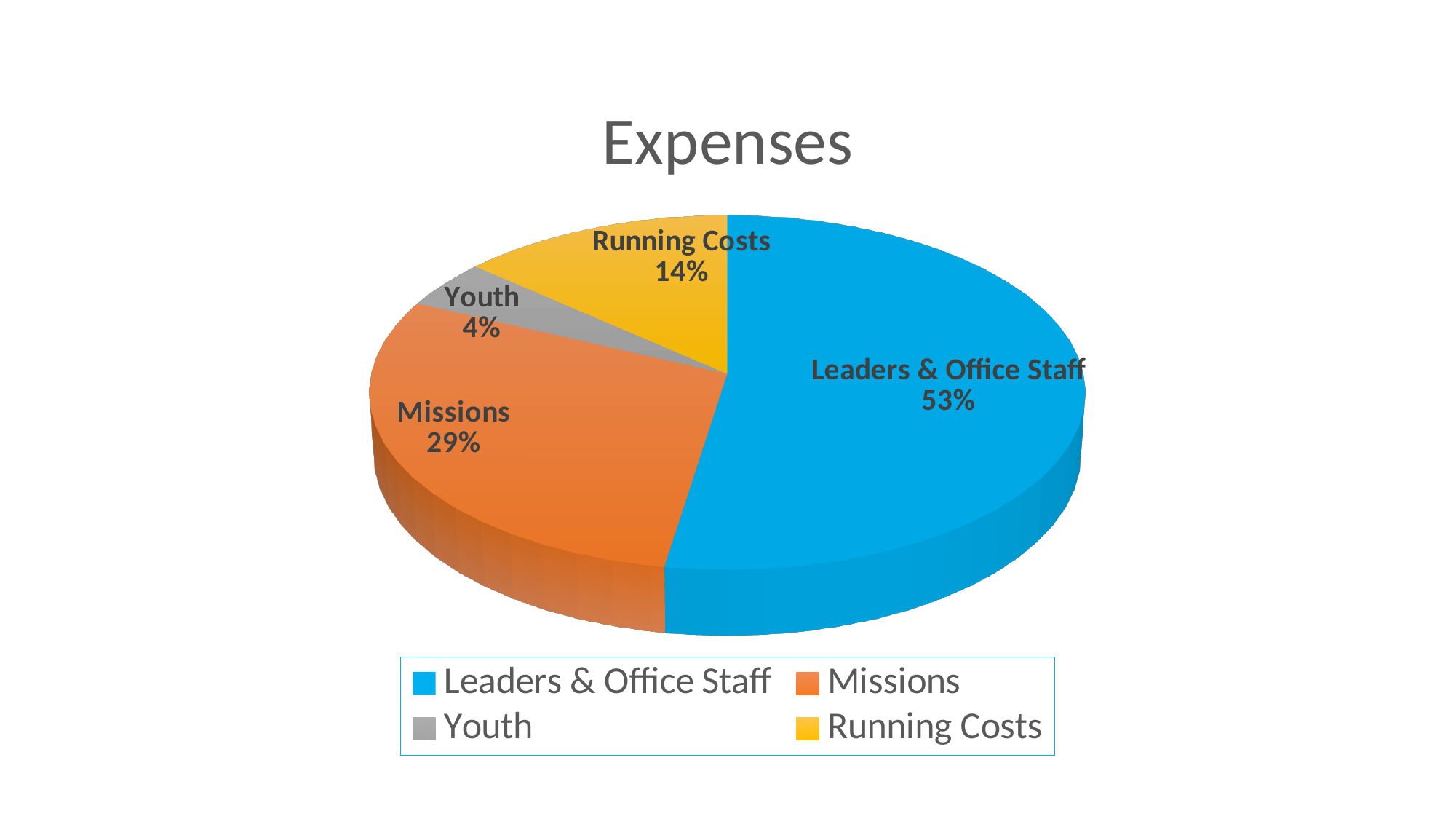
What share of expenses goes to Leaders & Office Staff? 53% What colour represents Missions in the chart? Orange Which category has the largest share of expenses? Leaders & Office Staff How many categories are shown in the pie chart? 4 What kind of chart is shown on the slide? Pie chart Which category has the smallest share of expenses? Youth What is the difference in percentage points between Leaders & Office Staff and Missions? 24 What is the title of the chart? Expenses What share of expenses goes to Missions? 29% Which is larger, the share for Running Costs or the share for Youth? Running Costs What share of expenses goes to Youth? 4%